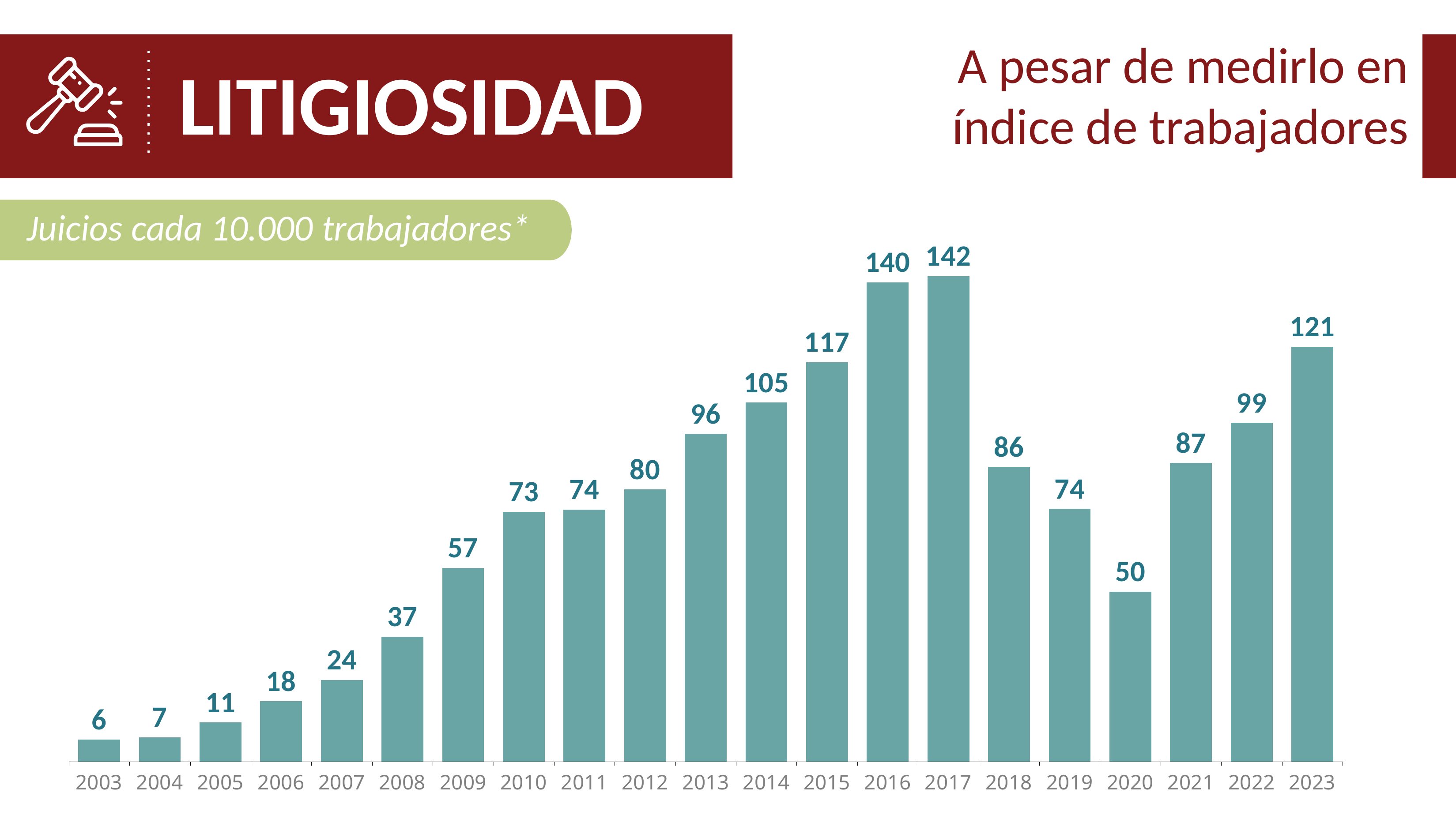
Which is larger, the value for 2013 or the value for 2019? 2013 What kind of chart is shown on the slide? bar chart What is the value for 2023? 121 What is the value for 2020? 50 What is the difference between the values for 2017 and 2018? 56 What does the green label above the chart say the values represent? Juicios cada 10.000 trabajadores* Do the values rise or fall from 2003 to 2017? rise What is the difference between the values for 2023 and 2022? 22 Which year has the highest value? 2017 How many years are shown on the x axis? 21 What is the value for 2017? 142 Which year has the lowest value? 2003